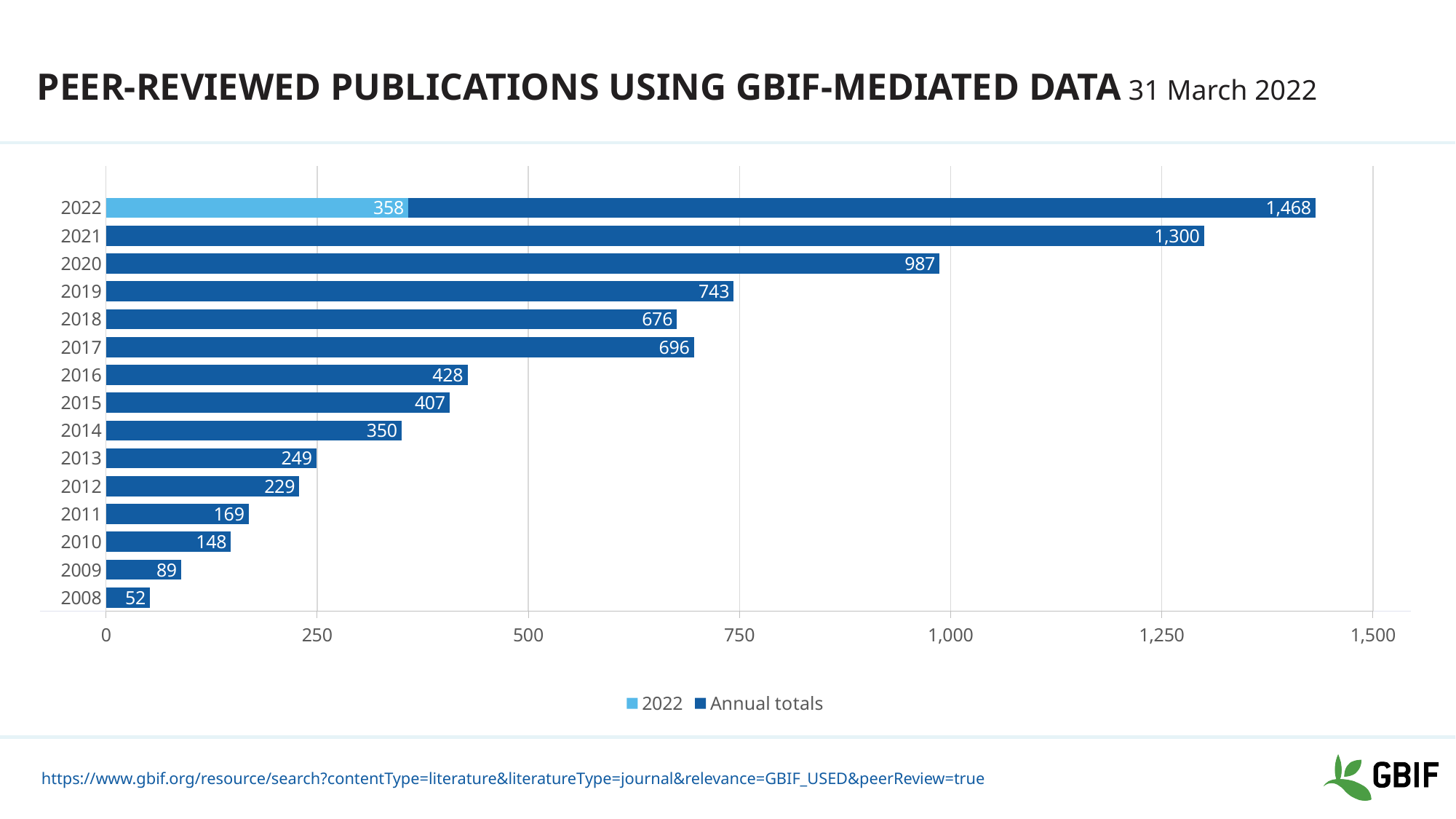
Which is larger, the annual total for 2017 or for 2018? 2017 What kind of chart is shown on the slide? bar chart What is the difference between the annual totals for 2021 and 2020? 313 How many years are shown on the chart? 15 What value is shown for the light blue 2022 segment? 358 How many series does the legend list? 2 What is the annual total for 2020? 987 What is the annual total of peer-reviewed publications for 2021? 1,300 What value is shown for 2008? 52 What are the two legend entries? 2022 and Annual totals Which year has the highest value labelled on the chart? 2022 Which year has the lowest annual total? 2008